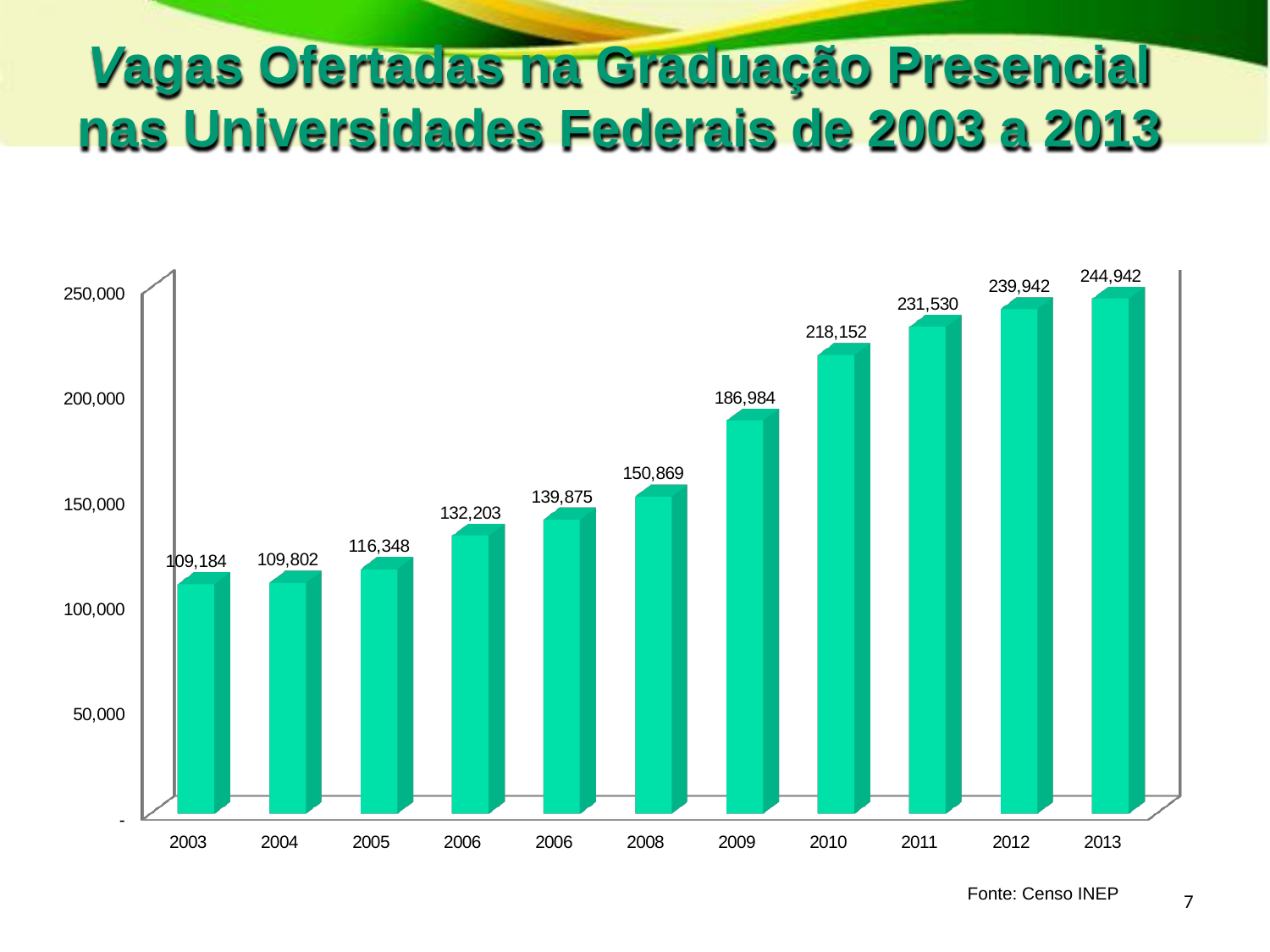
Do the values rise or fall from 2003 to 2013? rise What is the value for 2010? 218,152 Which year has the highest value? 2013 What is the value for 2003? 109,184 Which year has the lowest value? 2003 How many bars are shown in the chart? 11 What is the difference between the values for 2013 and 2003? 135,758 What kind of chart is shown on the slide? bar chart What is the value for 2011? 231,530 What is the difference between the values for 2012 and 2011? 8,412 Which is larger, the value for 2009 or the value for 2008? 2009 Is the value for 2009 greater or less than 150,000? greater